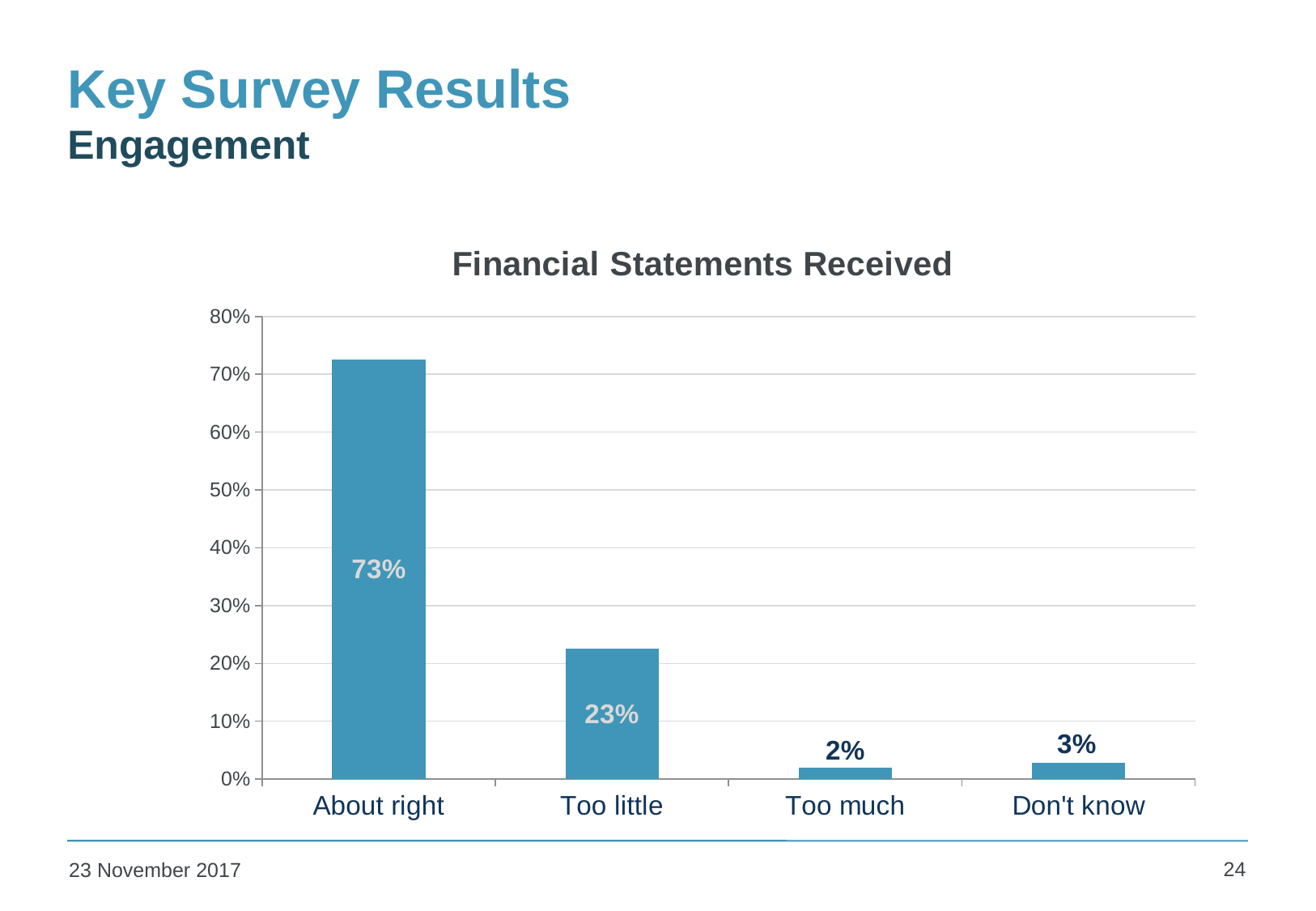
What is the value for "Too little"? 23% What is the value for "Too much"? 2% What kind of chart is shown on the slide? Bar chart What is the value for "Don't know"? 3% What is the title of the chart? Financial Statements Received Which category has the highest value? About right How many categories are shown on the x axis? 4 What is the difference between the values for "About right" and "Too little"? 50% Which category has the lowest value? Too much Is the value for "Too little" greater or less than 30%? less Which is larger, the value for "Don't know" or the value for "Too much"? Don't know What is the value for "About right"? 73%